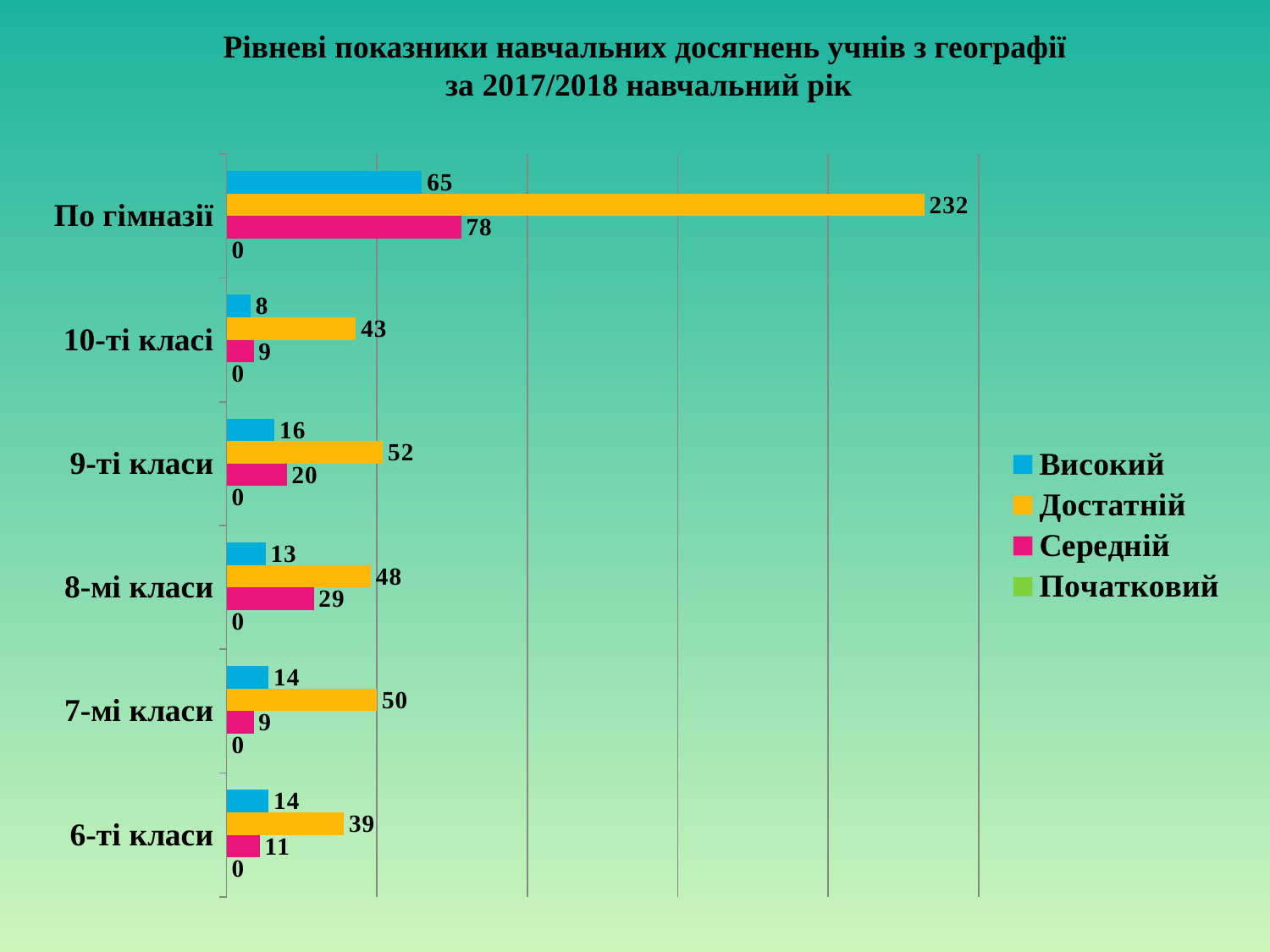
Which is larger: the Середній value for 9-ті класи or for 7-мі класи? 9-ті класи What is the value of Достатній for По гімназії? 232 Among the class categories (excluding По гімназії), which has the lowest Високий value? 10-ті класі Which category has the highest Достатній value? По гімназії What is the value of Початковий for 9-ті класи? 0 How many series does the legend list? 4 What is the value of Середній for 8-мі класи? 29 What is the value of Високий for 10-ті класі? 8 Which colour represents the Достатній series? Orange/yellow What is the difference between the Достатній values for 9-ті класи and 6-ті класи? 13 How many categories are shown on the chart? 6 What kind of chart is shown on the slide? Bar chart